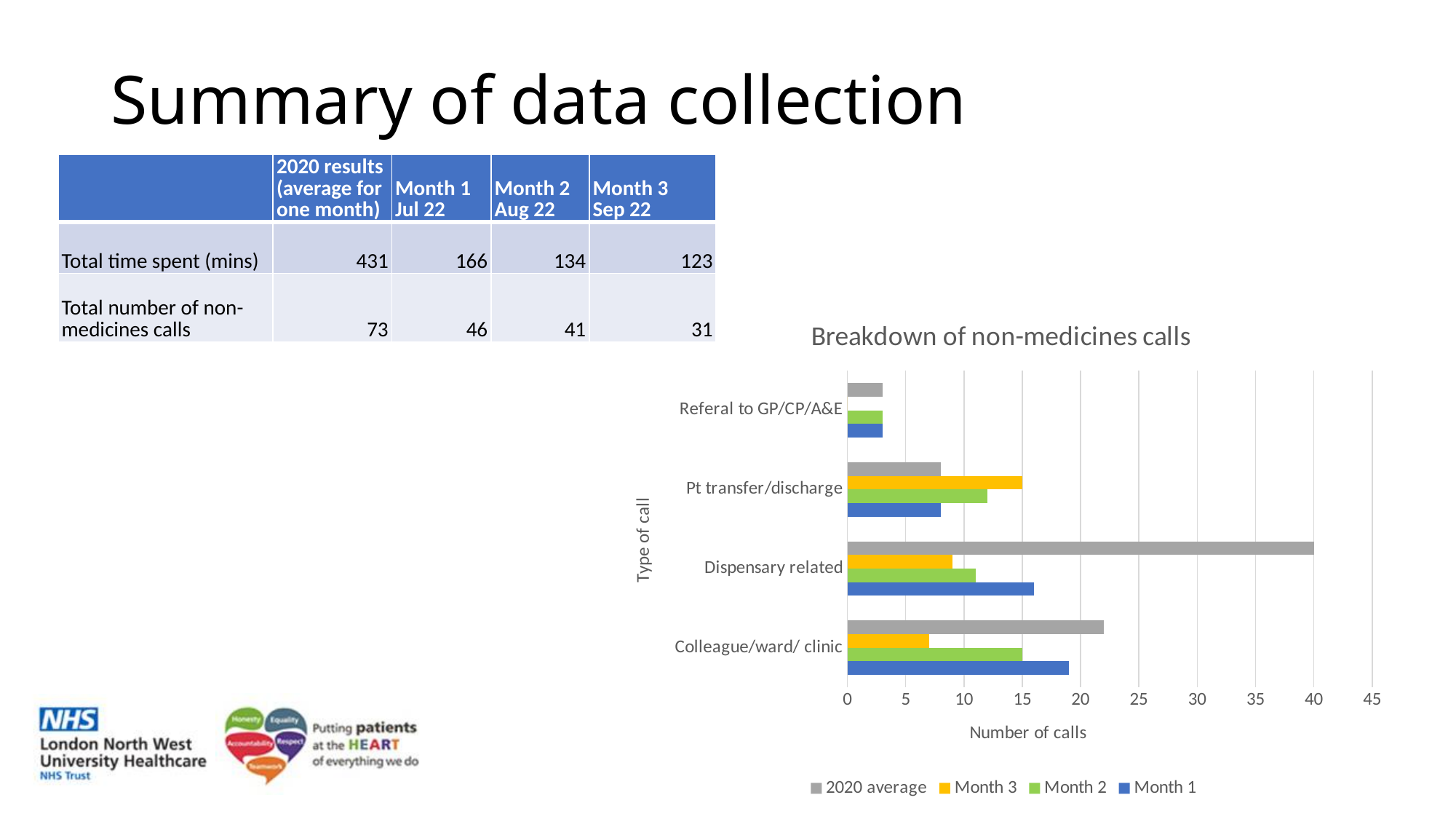
How many types of call are shown on the 'Breakdown of non-medicines calls' chart? 4 What is the x-axis title of the 'Breakdown of non-medicines calls' chart? Number of calls In the 'Breakdown of non-medicines calls' chart, which type of call has the lowest 2020 average? Referal to GP/CP/A&E In the 'Breakdown of non-medicines calls' chart, which type of call has the highest Month 3 value? Pt transfer/discharge How many series does the legend of the 'Breakdown of non-medicines calls' chart list? 4 In the 'Breakdown of non-medicines calls' chart, is the Month 1 value for Colleague/ward/ clinic greater or less than 15? greater What kind of chart is 'Breakdown of non-medicines calls'? bar chart In the 'Breakdown of non-medicines calls' chart, what is the 2020 average number of calls for Dispensary related? 40 In the 'Breakdown of non-medicines calls' chart, which type of call has the highest 2020 average? Dispensary related In the 'Breakdown of non-medicines calls' chart, for Dispensary related, which is larger: the 2020 average or Month 1? 2020 average In the 'Breakdown of non-medicines calls' chart, is the Month 1 value for Referal to GP/CP/A&E greater or less than 5? less In the 'Breakdown of non-medicines calls' chart, what is the Month 3 number of calls for Pt transfer/discharge? 15